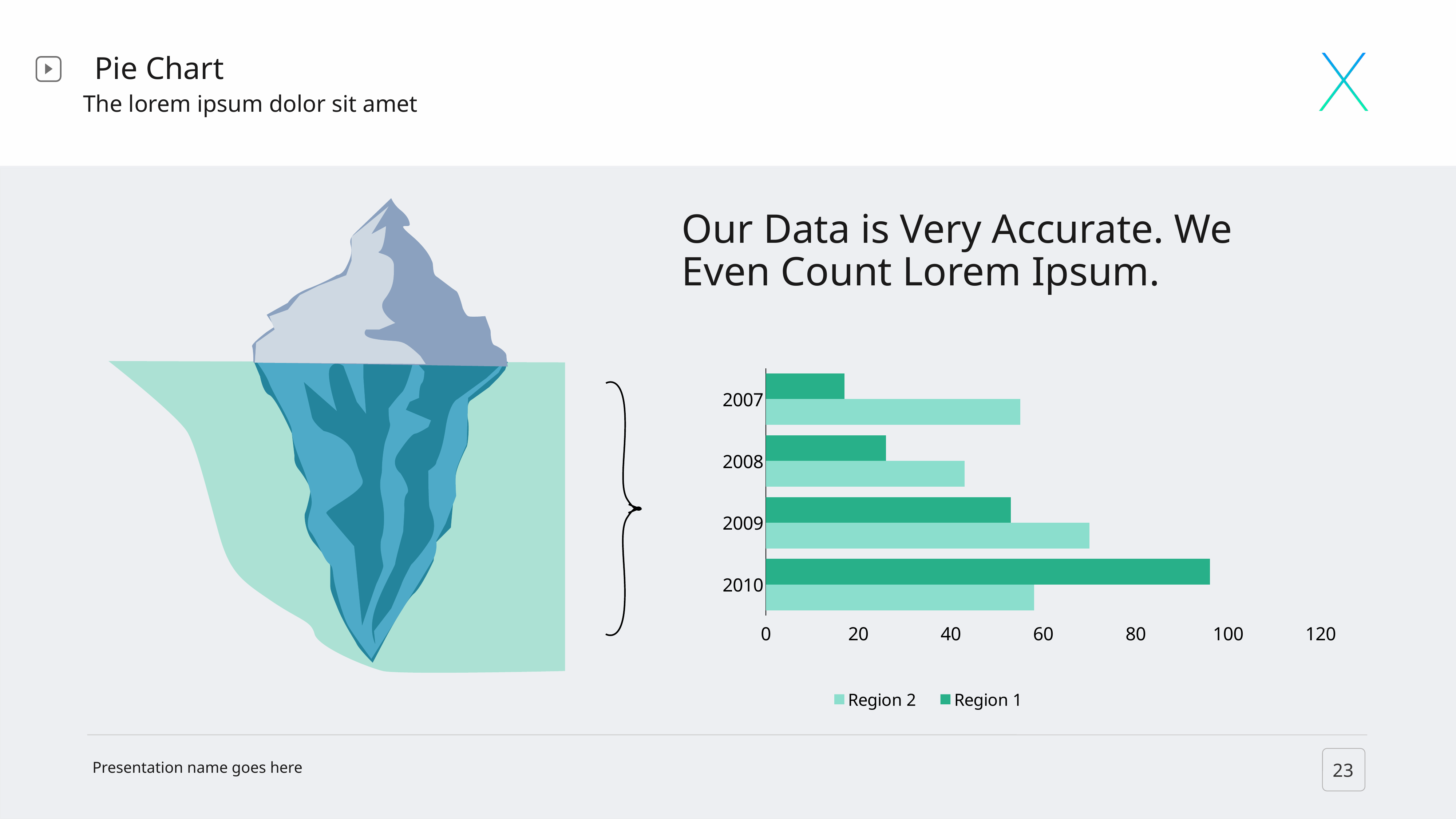
In 2010, which series has the larger value, Region 1 or Region 2? Region 1 Which year has the lowest value for Region 1? 2007 How many years are shown on the chart's vertical axis? 4 How many series does the chart's legend list? 2 Is the value for Region 1 in 2007 greater or less than 20? less Which year has the lowest value for Region 2? 2008 Which year has the highest value for Region 1? 2010 In 2007, which series has the larger value, Region 1 or Region 2? Region 2 Is the value for Region 1 in 2010 greater or less than 80? greater Which year has the highest value for Region 2? 2009 What kind of chart is shown on the slide? bar chart Do the Region 1 values rise or fall from 2007 to 2010? rise